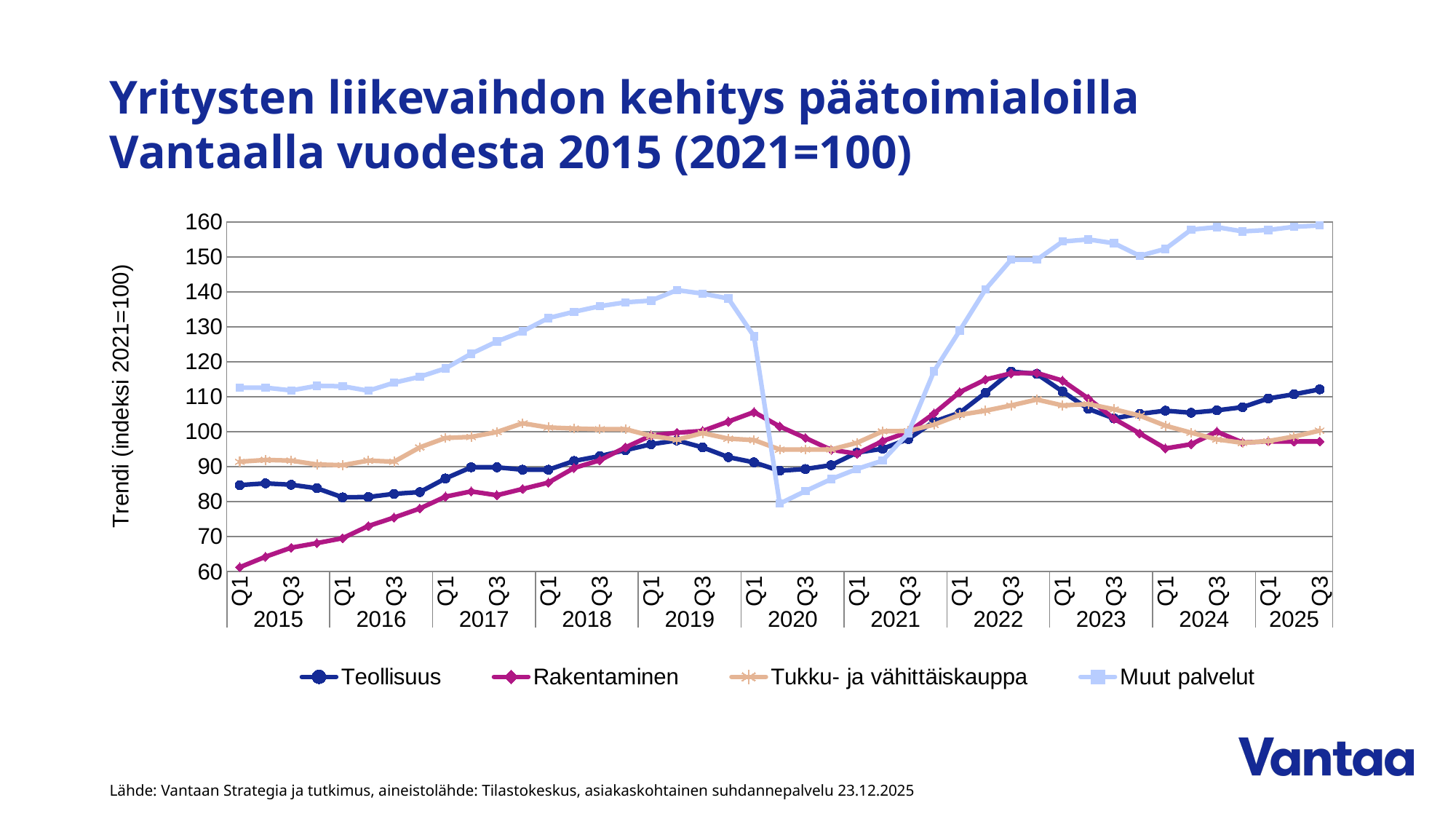
Is the value for Rakentaminen at Q1 2015 greater or less than 70? less How many series does the legend list? 4 Is the value for Muut palvelut at Q3 2025 greater or less than 150? greater How many years are labelled on the x axis? 11 At Q1 2015, which is higher: Teollisuus or Rakentaminen? Teollisuus Is the value for Muut palvelut at Q2 2020 greater or less than 90? less Which series has the highest value at Q3 2025? Muut palvelut At Q1 2022, which is higher: Muut palvelut or Rakentaminen? Muut palvelut Which series has the lowest value at Q1 2015? Rakentaminen Does the Rakentaminen series rise or fall from Q1 2015 to Q3 2017? rise What is the label of the y axis? Trendi (indeksi 2021=100) What kind of chart is shown on the slide? line chart